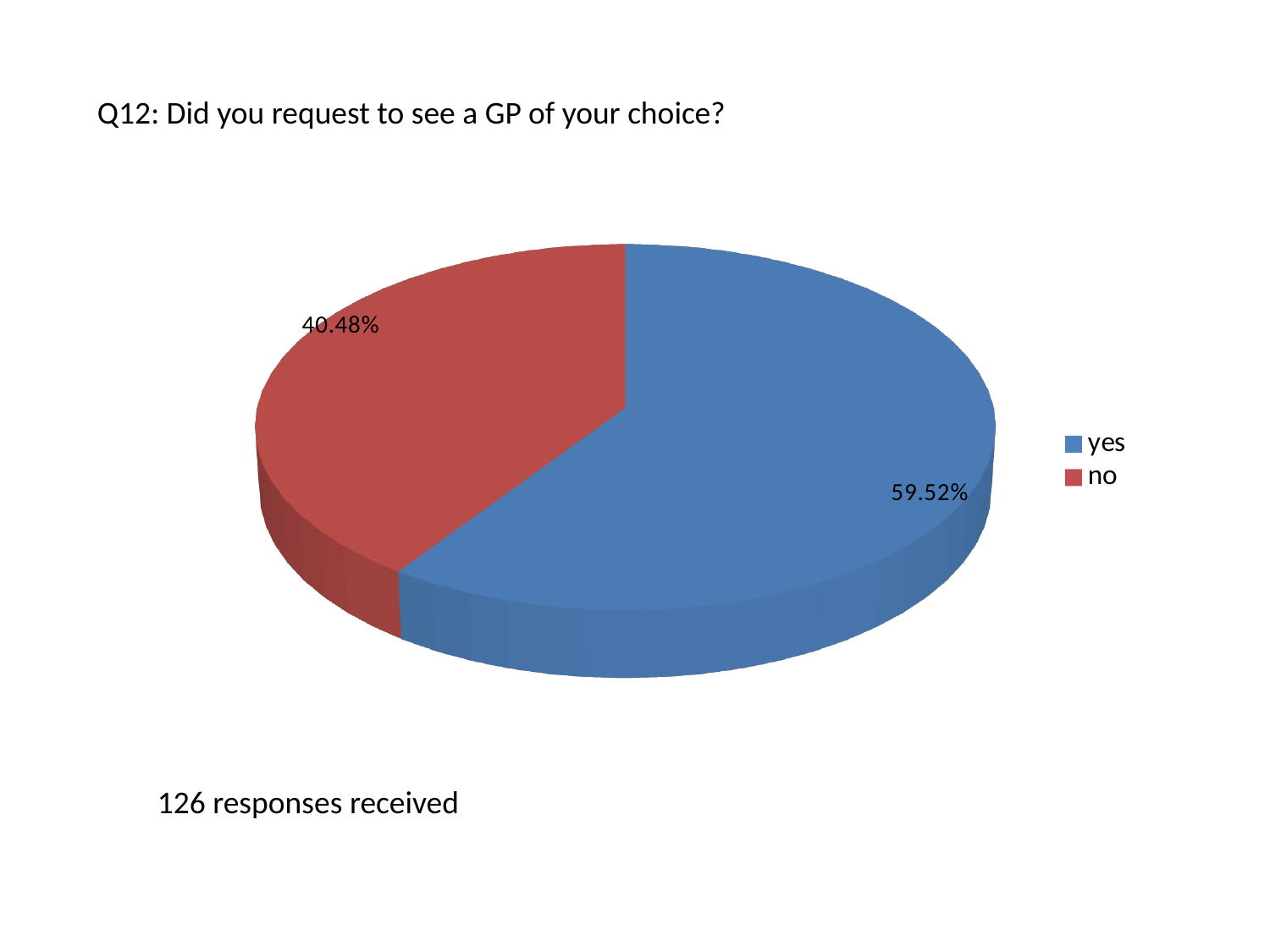
What is the title of the chart? Q12: Did you request to see a GP of your choice? What percentage of respondents answered "no"? 40.48% What kind of chart is shown on the slide? pie chart How many responses were received for this question? 126 What is the difference in percentage points between the "yes" and "no" shares? 19.04 What percentage of respondents answered "yes"? 59.52% Which response has the smallest share of the pie? no How many slices does the pie chart have? 2 How many entries does the legend list? 2 Which response has the largest share of the pie? yes Which is larger, the share for "yes" or the share for "no"? yes What colour is the "no" slice? red